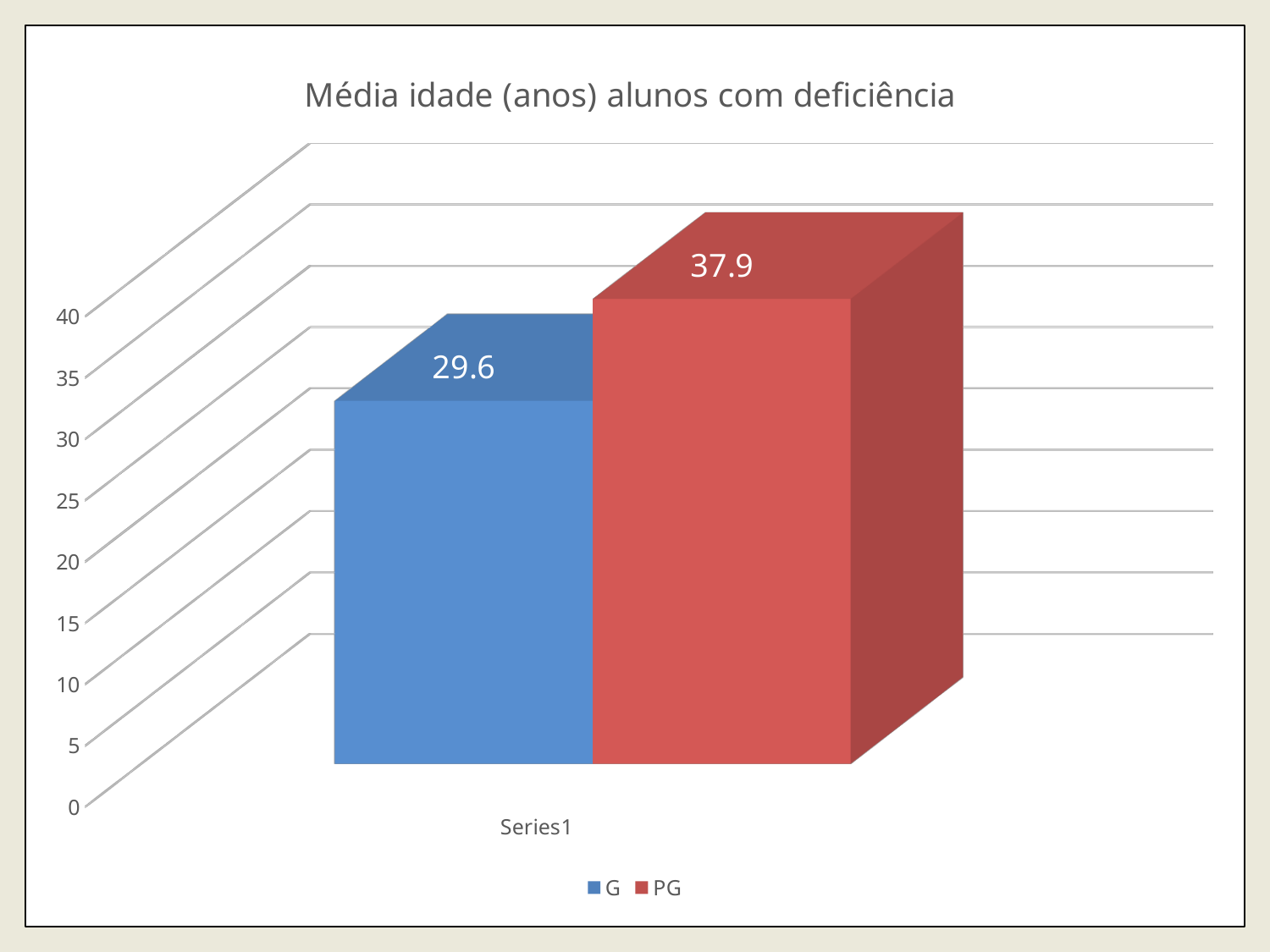
Which series has the higher value, G or PG? PG How many series does the legend list? 2 What kind of chart is shown on the slide? bar chart Is the value for PG greater or less than 35? greater What is the difference between the values for PG and G? 8.3 What is the value for G? 29.6 What colour is the bar for PG? red What is the value for PG? 37.9 Is the value for G larger or smaller than the value for PG? smaller Is the value for G greater or less than 30? less Which series has the lower value, G or PG? G What is the title of the chart? Média idade (anos) alunos com deficiência